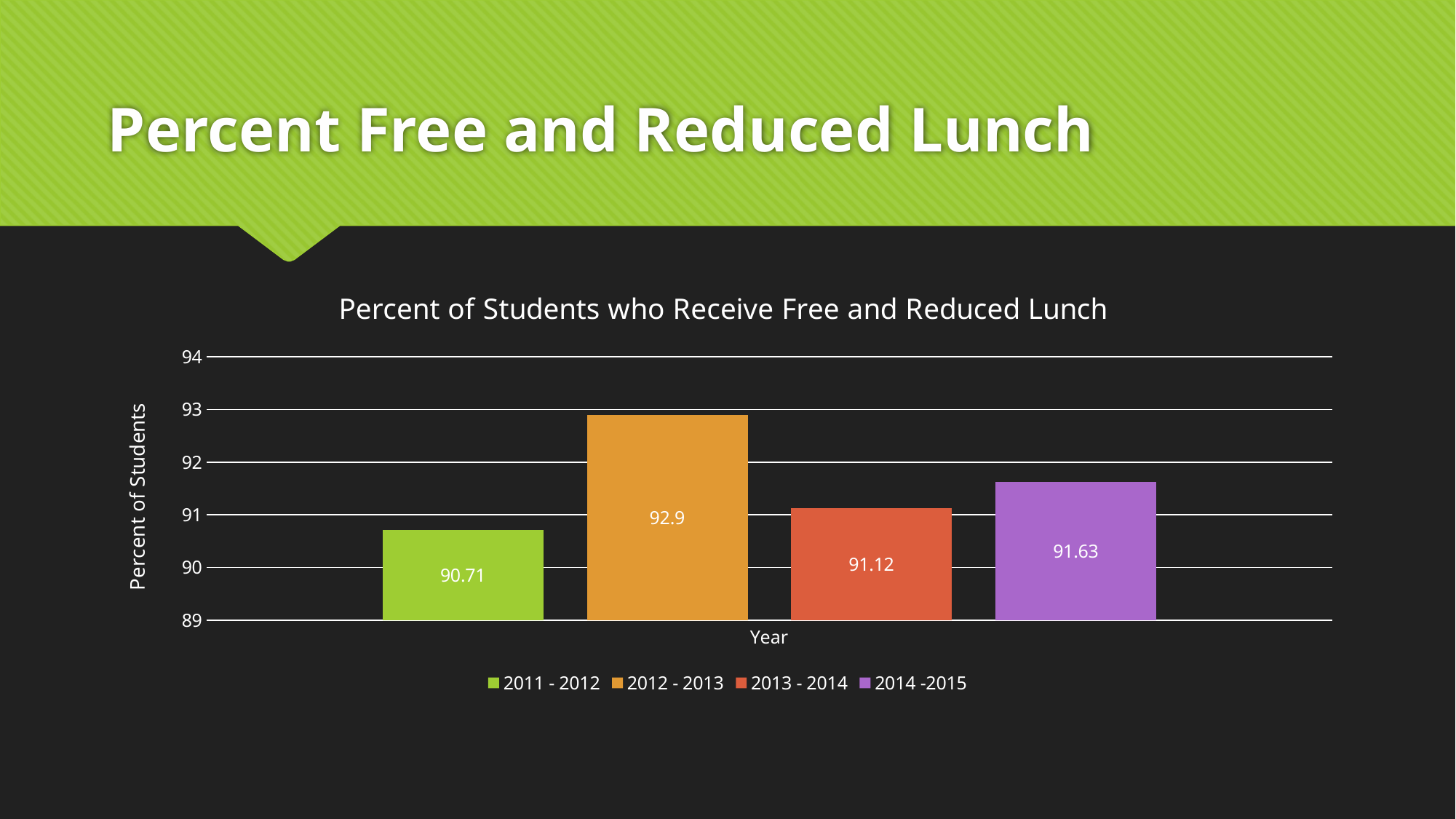
What is the value for 2011 - 2012? 90.71 Which year has the lowest percent of students receiving free and reduced lunch? 2011 - 2012 What is the difference between the values for 2012 - 2013 and 2011 - 2012? 2.19 What is the title of the chart? Percent of Students who Receive Free and Reduced Lunch What is the value for 2014 -2015? 91.63 Which year has the highest percent of students receiving free and reduced lunch? 2012 - 2013 Which is larger, the value for 2013 - 2014 or the value for 2014 -2015? 2014 -2015 What is the value for 2012 - 2013? 92.9 Is the value for 2012 - 2013 greater or less than 92? greater What kind of chart is shown on the slide? bar chart What is the value for 2013 - 2014? 91.12 How many bars are shown in the chart? 4